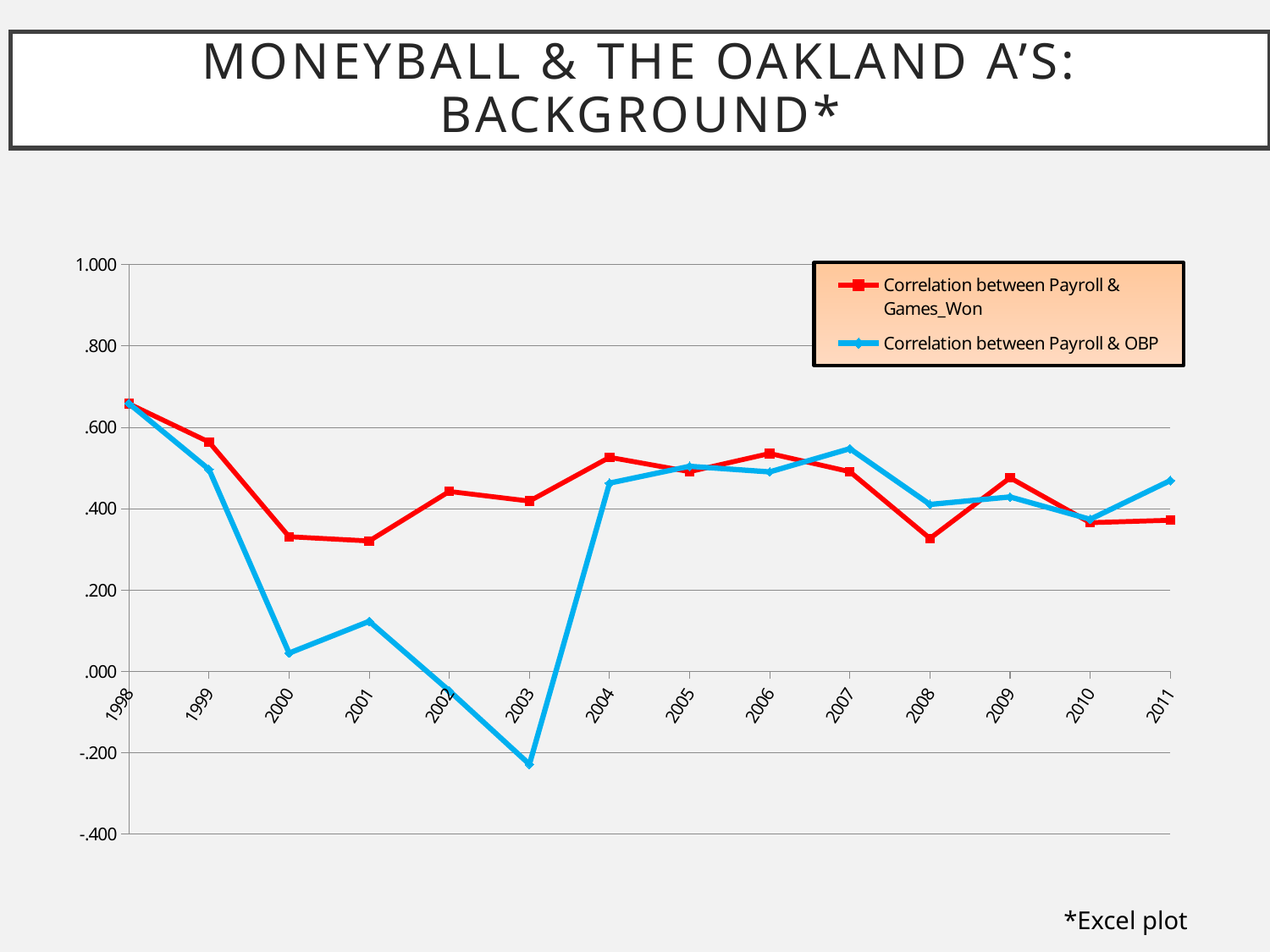
How many series does the legend list? 2 Does the Correlation between Payroll & OBP line rise or fall from 2003 to 2004? rise In 2001, which series has the larger value: Correlation between Payroll & Games_Won or Correlation between Payroll & OBP? Correlation between Payroll & Games_Won What kind of chart is shown on the slide? line chart Is the value for Correlation between Payroll & OBP in 2003 greater or less than .000? less Does the Correlation between Payroll & Games_Won line rise or fall from 1998 to 2001? fall How many years are plotted along the x axis? 14 Which year has the highest value for Correlation between Payroll & Games_Won? 1998 Is the value for Correlation between Payroll & OBP in 2000 greater or less than .200? less Which year has the lowest value for Correlation between Payroll & OBP? 2003 What colour is the line for Correlation between Payroll & OBP? blue Is the value for Correlation between Payroll & Games_Won in 2006 greater or less than .400? greater